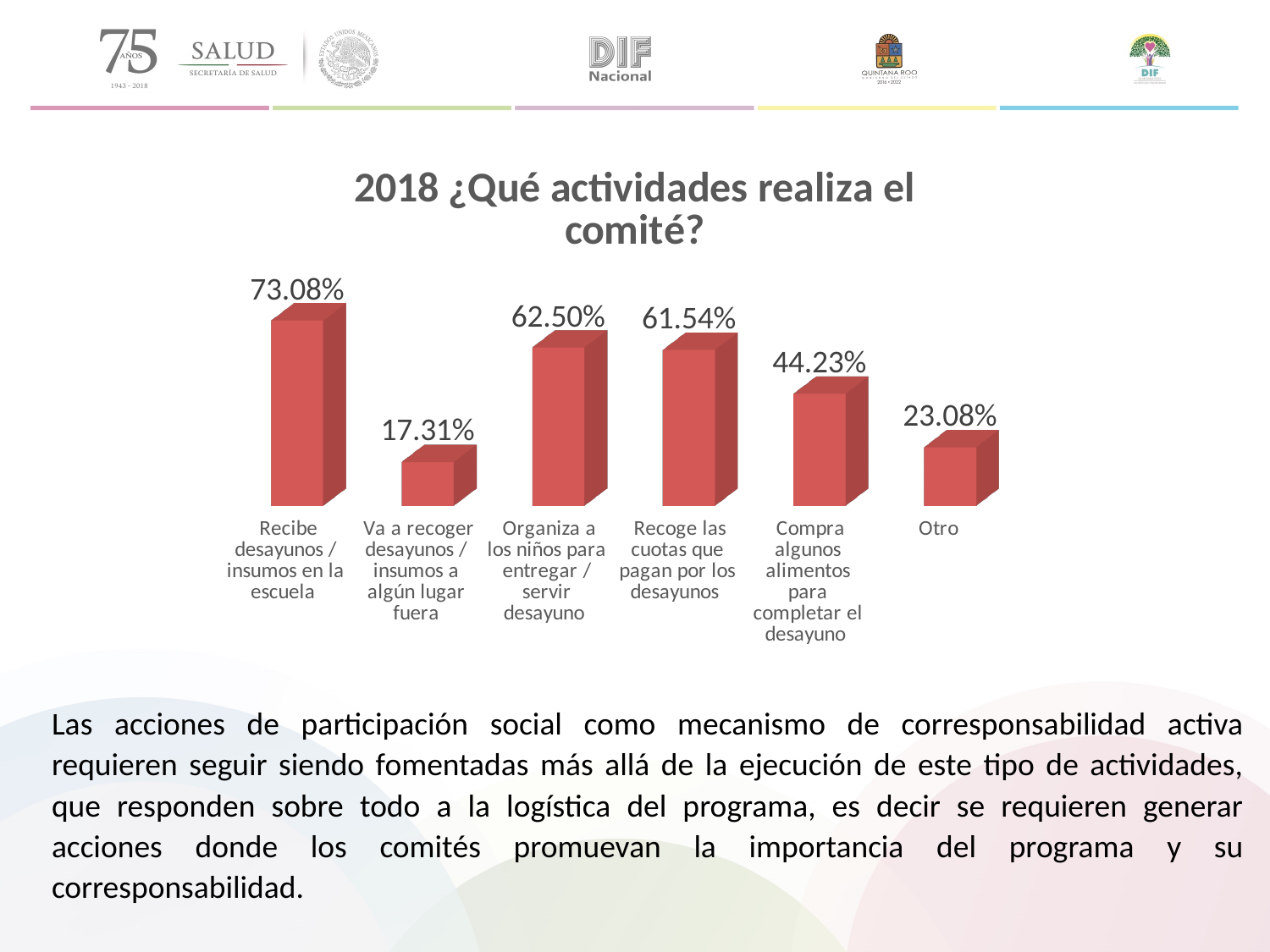
Which category has the highest value? Recibe desayunos / insumos en la escuela Which is larger: "Compra algunos alimentos para completar el desayuno" or "Otro"? Compra algunos alimentos para completar el desayuno What is the title of the chart? 2018 ¿Qué actividades realiza el comité? What is the value for "Otro"? 23.08% What colour are the bars in the chart? Red What is the value for "Recibe desayunos / insumos en la escuela"? 73.08% What is the difference between "Organiza a los niños para entregar / servir desayuno" and "Recoge las cuotas que pagan por los desayunos"? 0.96% What kind of chart is this? Bar chart What is the value for "Compra algunos alimentos para completar el desayuno"? 44.23% Which category has the lowest value? Va a recoger desayunos / insumos a algún lugar fuera How many categories are shown in the chart? 6 What is the difference between "Recibe desayunos / insumos en la escuela" and "Otro"? 50.00%